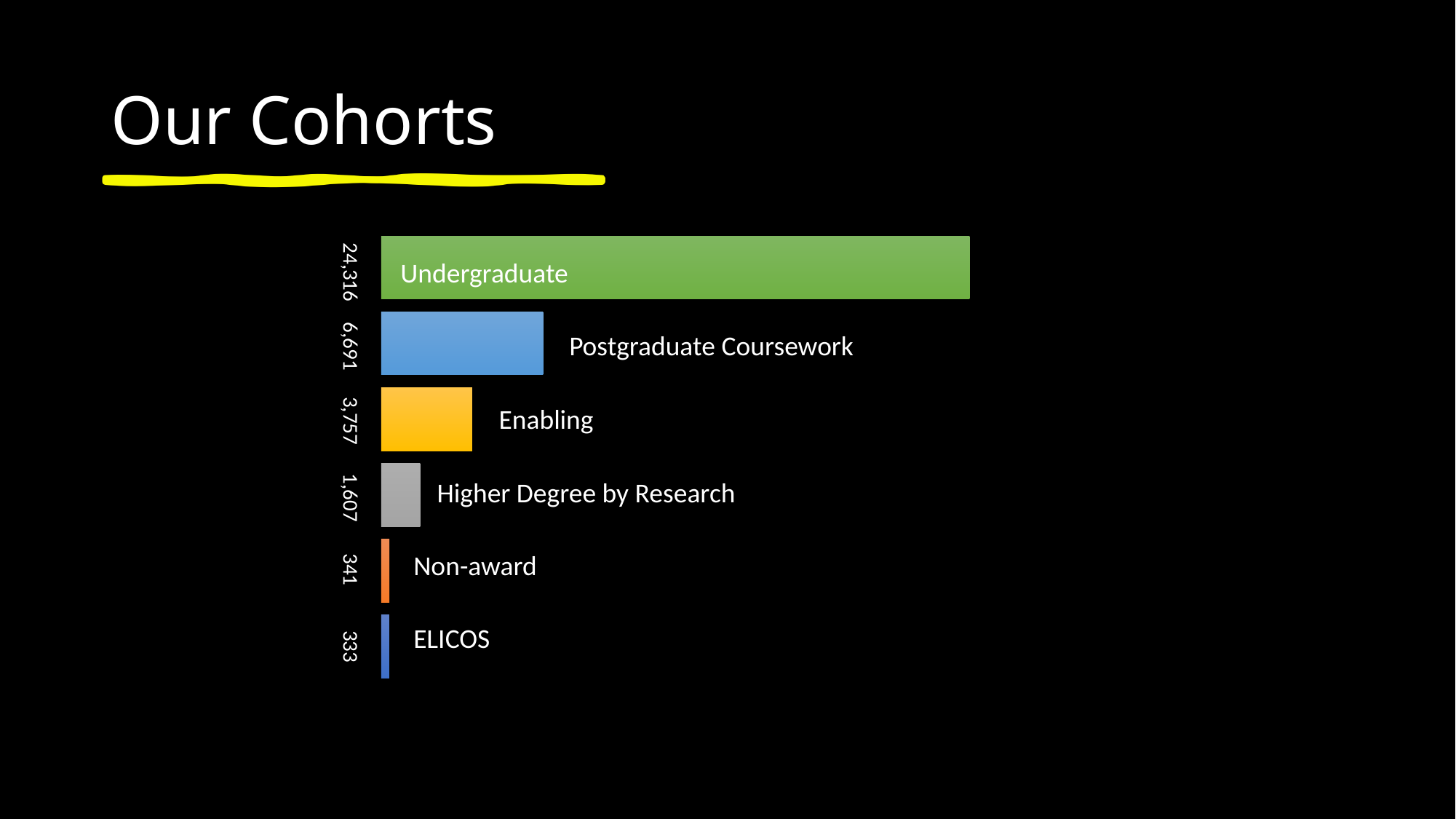
What is the value for ELICOS? 333 Which cohort has the lowest value? ELICOS What is the value for Enabling? 3,757 What kind of chart is shown on the slide? Bar chart Which cohort has the highest value? Undergraduate Which is larger, Non-award or ELICOS? Non-award What is the difference between the Undergraduate and Postgraduate Coursework values? 17,625 What is the value for Postgraduate Coursework? 6,691 What is the value for Undergraduate? 24,316 What is the difference between the Enabling and Higher Degree by Research values? 2,150 How many cohorts are shown in the chart? 6 What is the value for Higher Degree by Research? 1,607